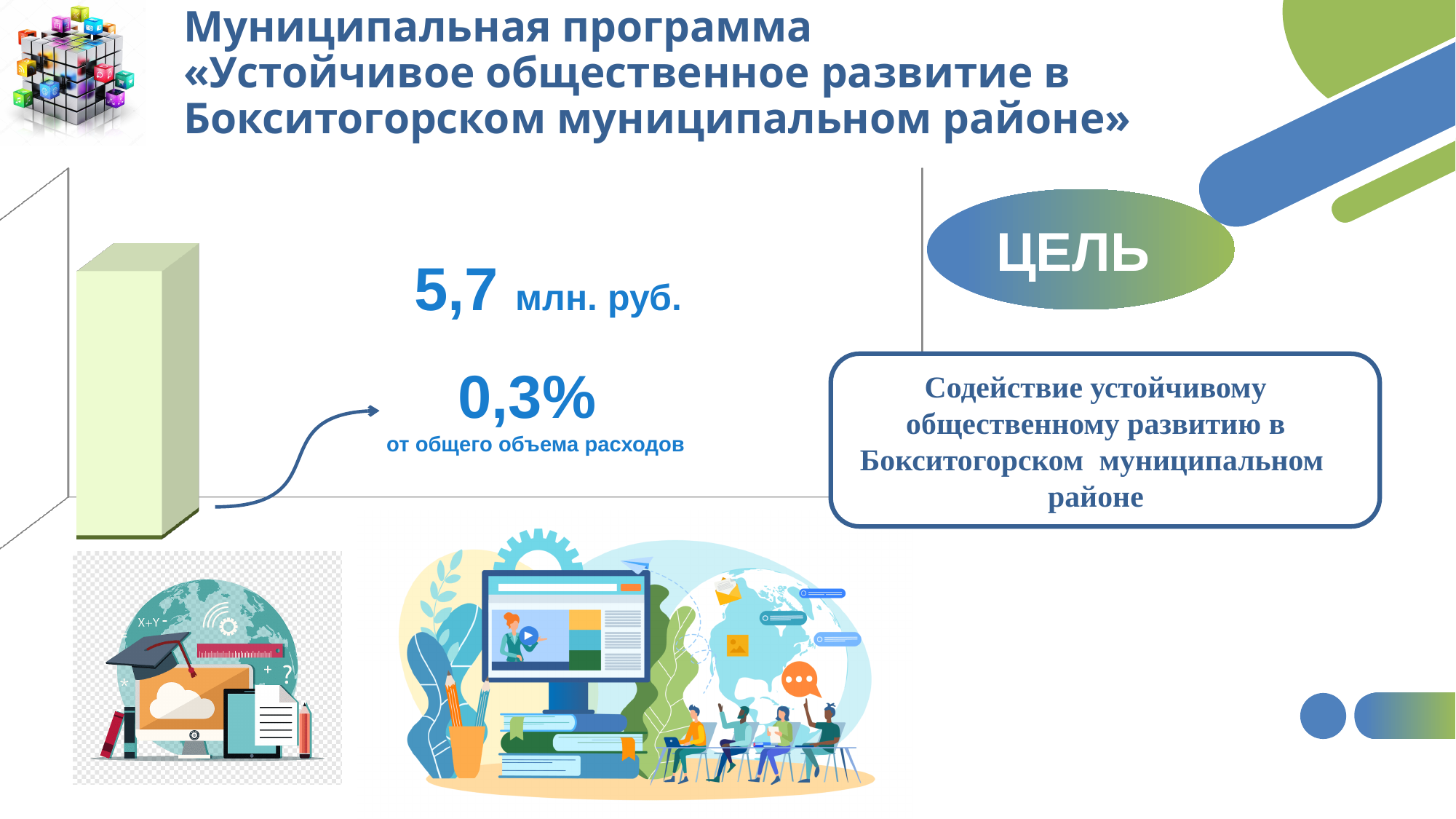
What kind of chart is shown on the left side of the slide? bar chart What colour is the bar in the chart on the left side of the slide? light green Is the share of total expenditure shown for the bar on the left side of the slide greater or less than 1%? less What amount in million rubles is shown next to the bar on the left side of the slide? 5,7 млн. руб. What percentage of total expenditure does the bar on the left side of the slide represent? 0,3% How many bars does the chart on the left side of the slide contain? 1 What text is written below the 0,3% figure next to the bar on the left side of the slide? от общего объема расходов